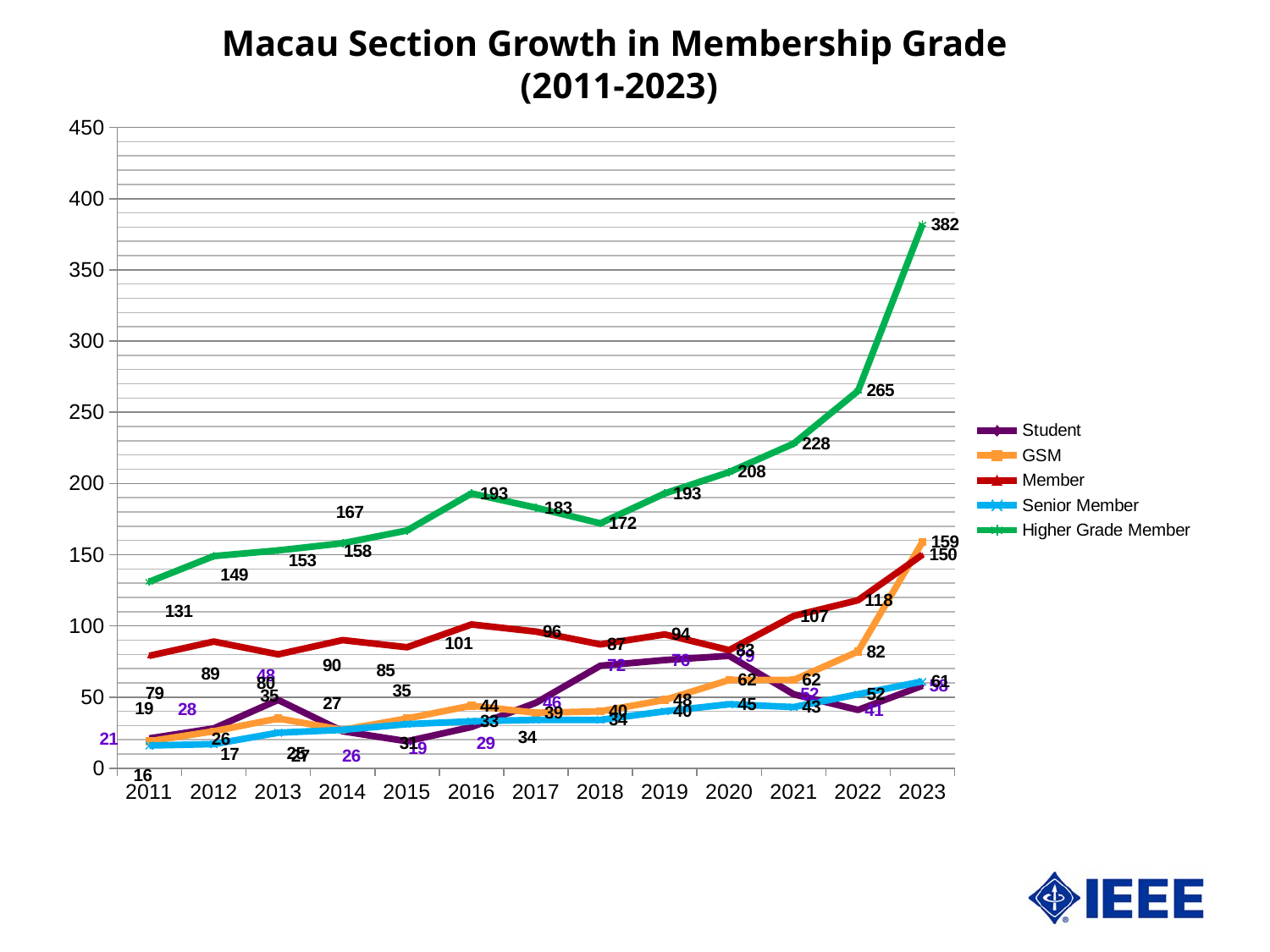
What type of chart is shown on the slide? line chart What is the title of the chart? Macau Section Growth in Membership Grade (2011-2023) What is the value for GSM in 2023? 159 What is the difference between the Higher Grade Member values in 2023 and 2022? 117 What is the value for Higher Grade Member in 2023? 382 What is the value for Member in 2011? 79 What is the value for Higher Grade Member in 2016? 193 How many years are plotted along the x axis? 13 Is the value for Higher Grade Member in 2022 greater or less than 250? greater Which is larger in 2023, GSM or Member? GSM How many series does the legend list? 5 In which year is the Higher Grade Member value lowest? 2011